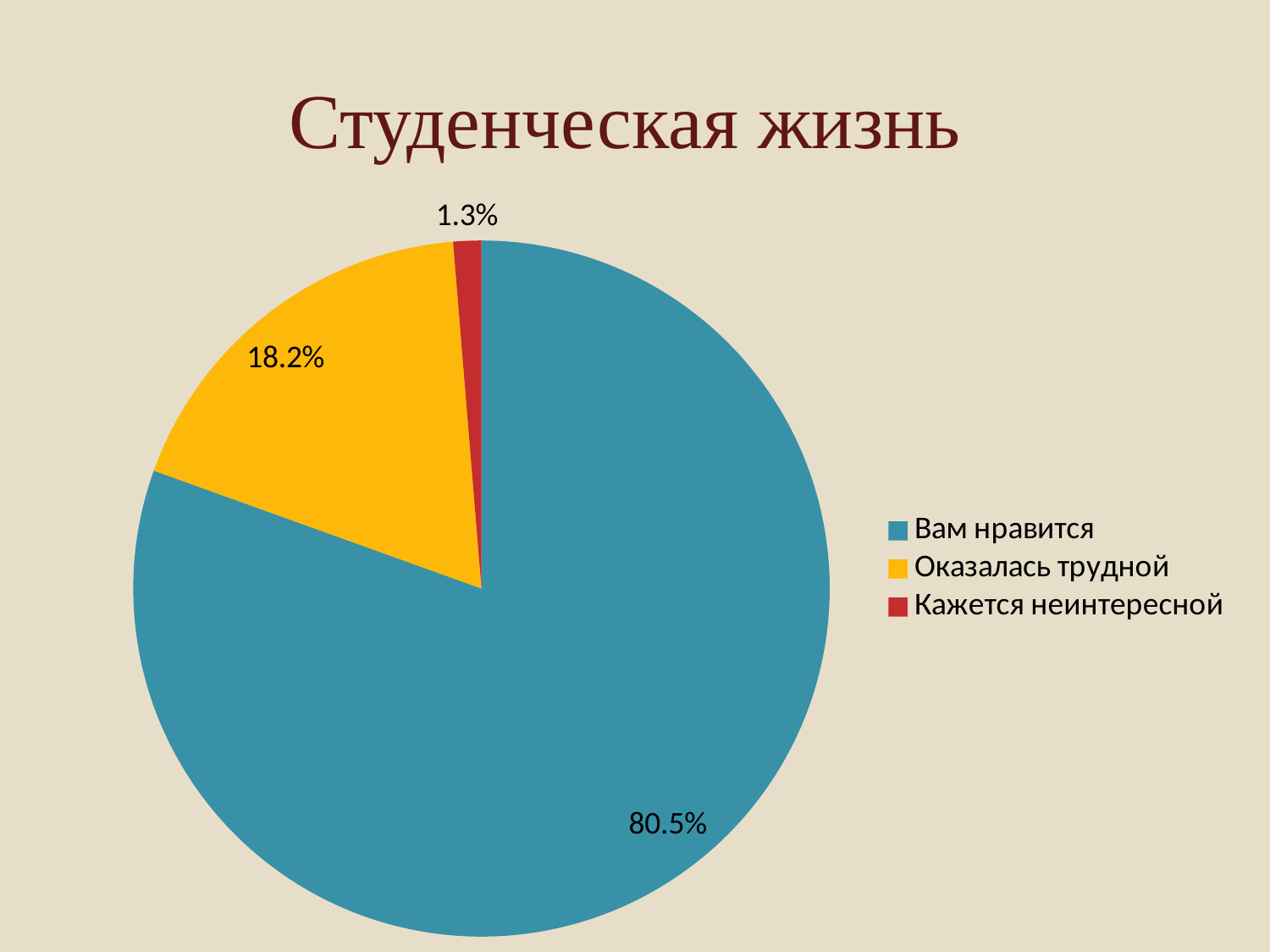
Which category has the smallest slice? Кажется неинтересной What share of the pie does "Кажется неинтересной" take? 1.3% What share of the pie does "Оказалась трудной" take? 18.2% What kind of chart is shown on the slide? pie chart What share of the pie does "Вам нравится" take? 80.5% What is the title of the chart? Студенческая жизнь How many entries does the legend list? 3 What colour is the slice for "Оказалась трудной"? yellow Which category has the largest slice? Вам нравится How many slices does the pie chart have? 3 What is the difference between the shares for "Вам нравится" and "Оказалась трудной"? 62.3% Which is larger, the share for "Оказалась трудной" or for "Кажется неинтересной"? Оказалась трудной